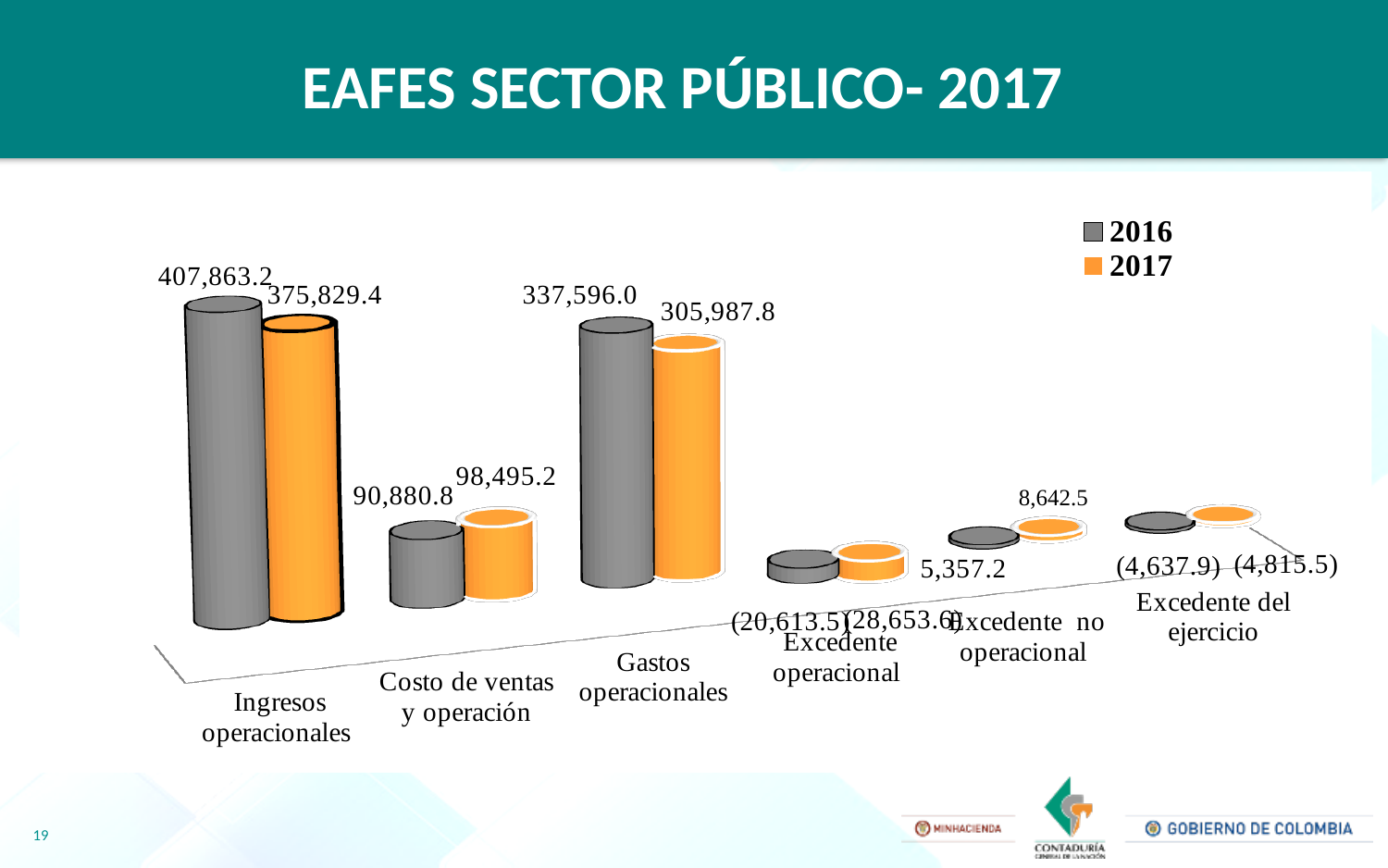
What is the 2017 value for Excedente no operacional? 8,642.5 Which category has the highest 2016 value? Ingresos operacionales What is the 2016 value for Ingresos operacionales? 407,863.2 What kind of chart is shown on the slide? Bar chart What is the difference between the 2016 and 2017 values for Gastos operacionales? 31,608.2 How many categories are shown on the x axis? 6 For Costo de ventas y operación, which year has the larger value, 2016 or 2017? 2017 What is the 2016 value for Excedente del ejercicio? (4,637.9) What is the 2016 value for Gastos operacionales? 337,596.0 How many series does the legend list? 2 What is the 2017 value for Ingresos operacionales? 375,829.4 What is the 2017 value for Costo de ventas y operación? 98,495.2